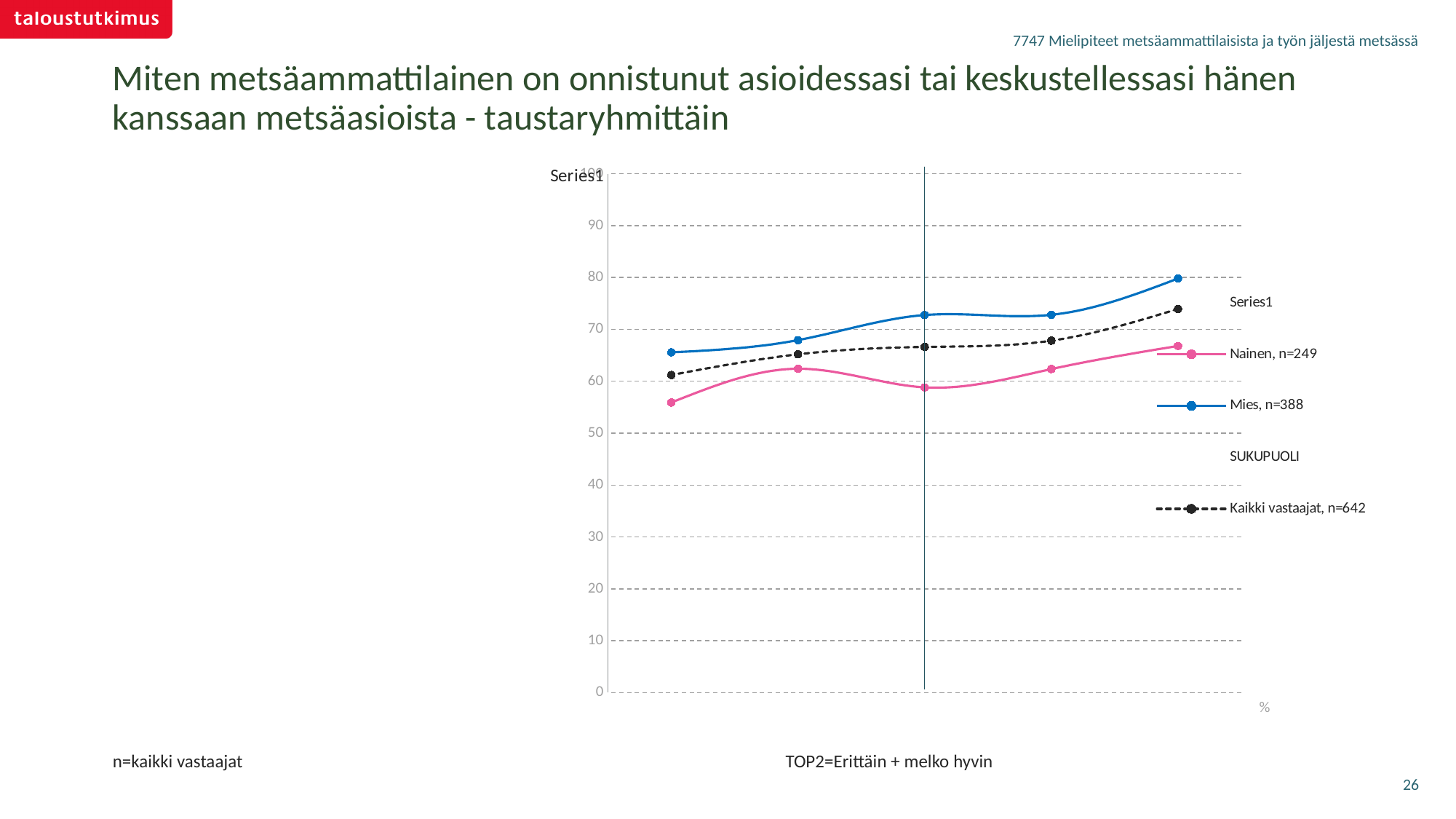
Is the first (leftmost) value for Nainen, n=249 greater or less than 60? less Which series reaches the highest value in the chart? Mies, n=388 What kind of chart is shown on the slide? line chart Which series has the lowest point in the chart? Nainen, n=249 Is the first (leftmost) value for Mies, n=388 greater or less than 60? greater Is the last (rightmost) value for Kaikki vastaajat, n=642 greater or less than 70? greater At the first (leftmost) point, which is higher: Mies, n=388 or Nainen, n=249? Mies, n=388 How many data points does the Mies, n=388 line have? 5 What unit is shown at the bottom of the vertical axis? % How many data series are plotted in the chart? 3 Does the Mies, n=388 line generally rise or fall from left to right? rise